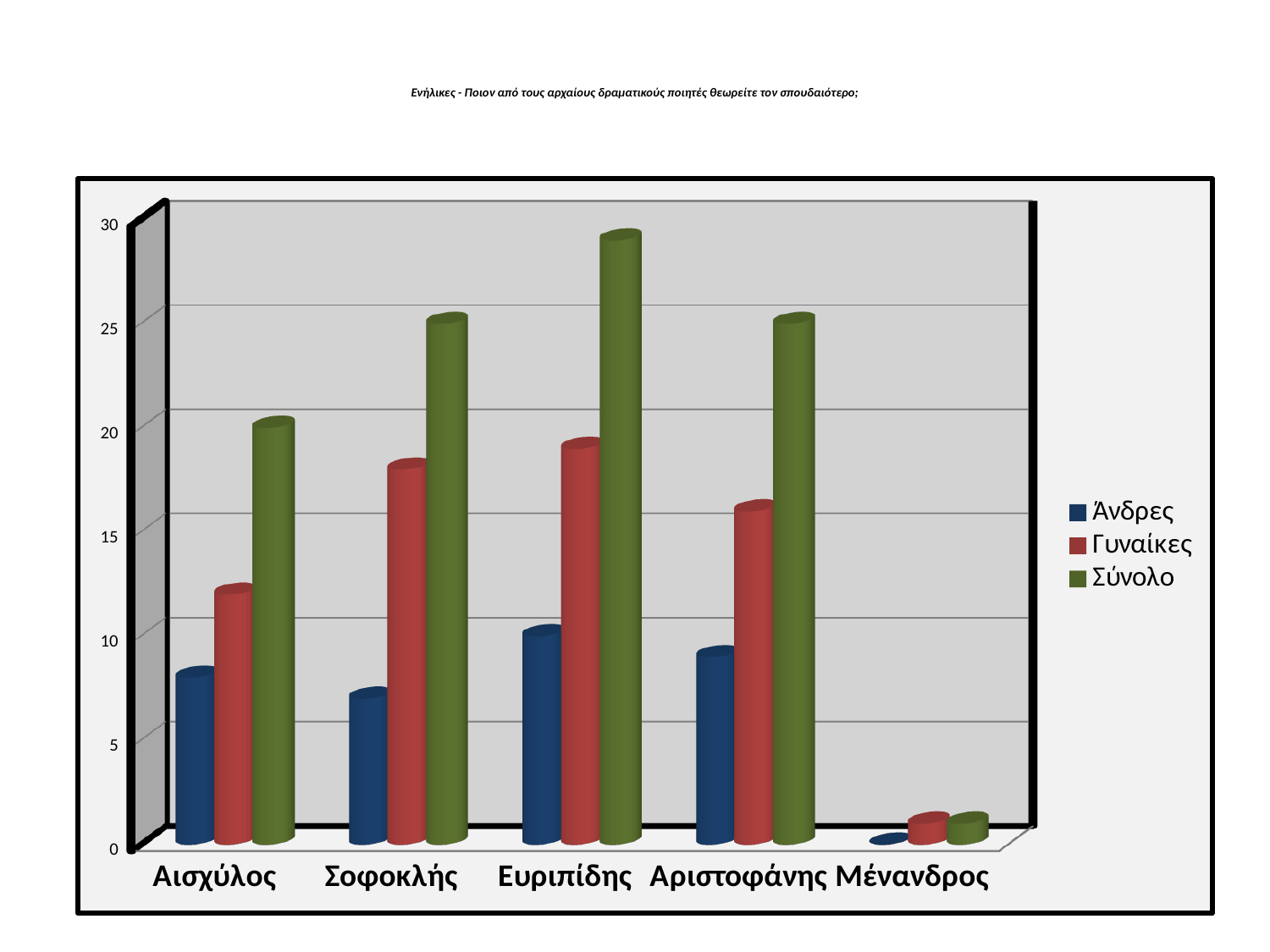
Which category has the highest Σύνολο value? Ευριπίδης How many categories (poets) are shown on the x axis? 5 Is the Σύνολο value for Αισχύλος greater or less than 25? less Is the Γυναίκες value for Σοφοκλής greater or less than 15? greater Is the Άνδρες value for Αισχύλος greater or less than 10? less Which is larger: the Γυναίκες value for Σοφοκλής or for Αισχύλος? Σοφοκλής Which category has the lowest Άνδρες value? Μένανδρος Which series is shown in green in the legend? Σύνολο How many series does the legend list? 3 What kind of chart is shown on the slide? bar chart Which category has the lowest Σύνολο value? Μένανδρος